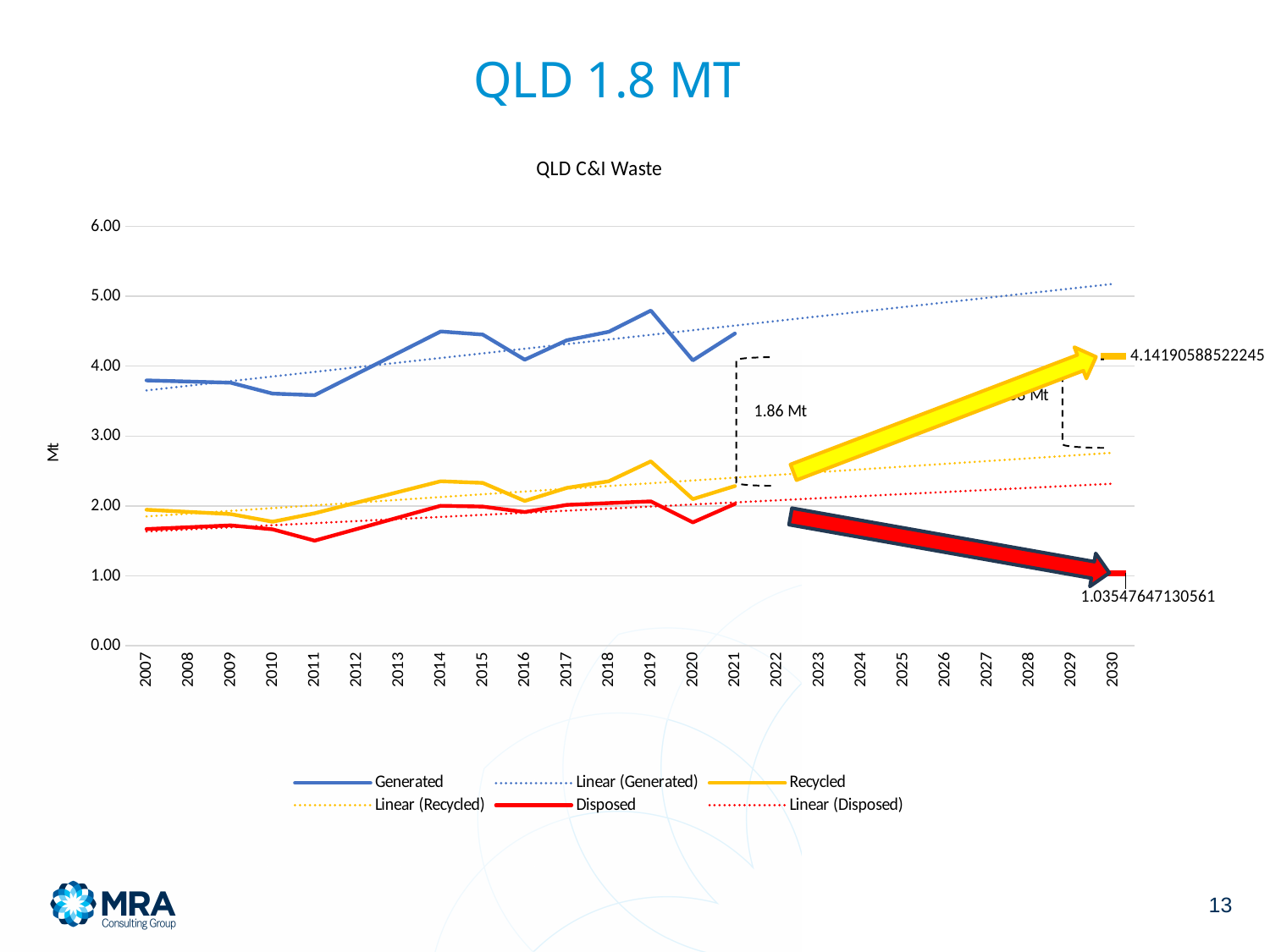
Which series has the lowest value in 2007? Disposed What value is labelled at the end of the red arrow for Disposed in 2030? 1.03547647130561 What is the title of the chart? QLD C&I Waste Is the value for Disposed in 2011 greater or less than 2.00? less Is the value for Generated in 2007 greater or less than 4.00? less Is the value for Generated in 2019 greater or less than 4.00? greater What is the label on the vertical axis? Mt Does the Generated line overall rise or fall from 2007 to 2021? rise Which series has the higher value in 2019, Generated or Recycled? Generated What kind of chart is shown on the slide? line chart What value is labelled at the end of the yellow arrow for Recycled in 2030? 4.14190588522245 How many series does the legend list? 6